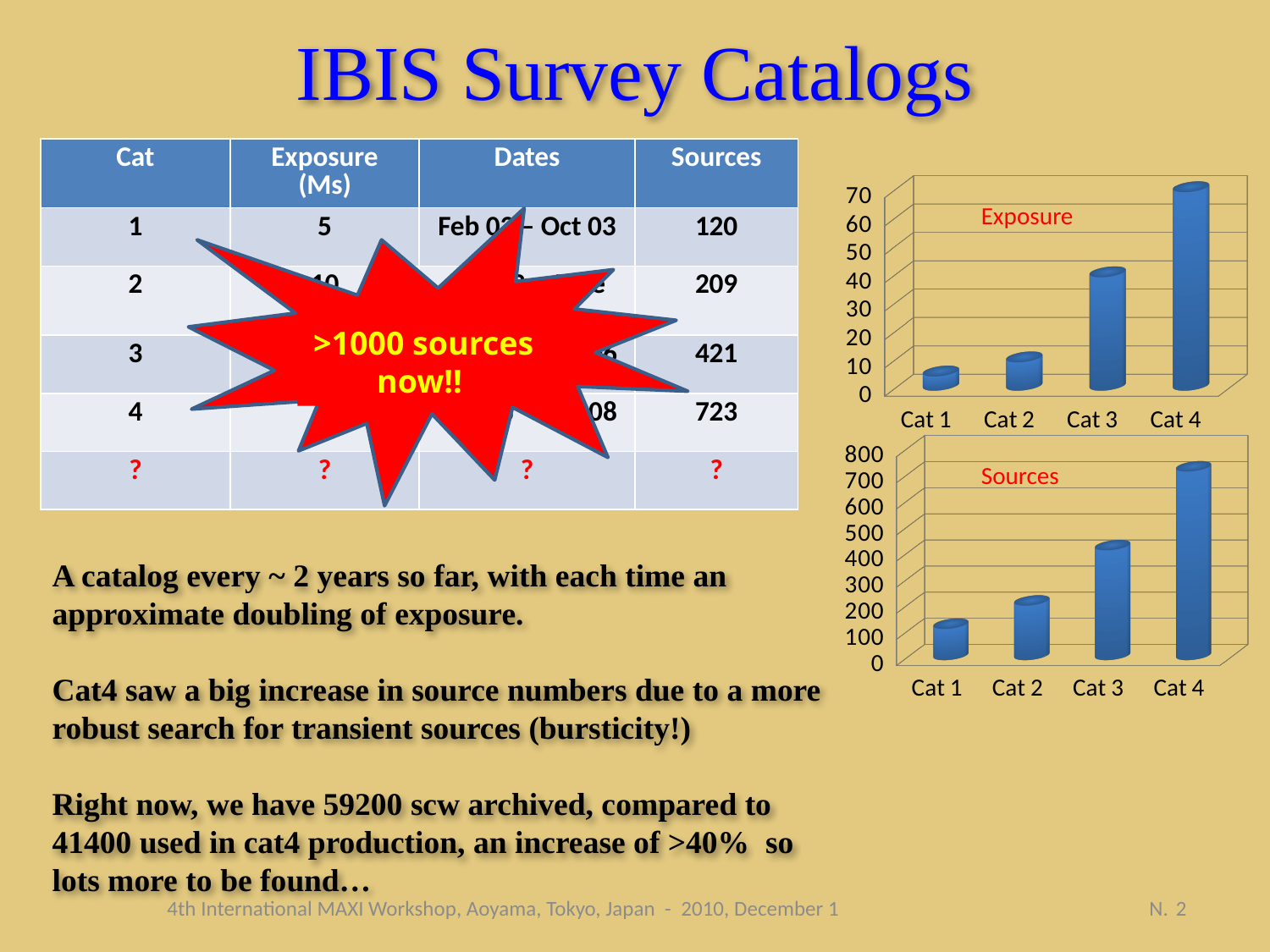
In the Sources chart, is the value for Cat 1 greater or less than 200? less How many categories are shown in the Sources chart? 4 In the Exposure chart, is the value for Cat 2 greater or less than 20? less In the Exposure chart, is the value for Cat 3 greater or less than 30? greater What kind of chart is the Exposure chart? bar chart In the Sources chart, which category has the highest value? Cat 4 In the Exposure chart, which category has the lowest value? Cat 1 In the Exposure chart, which is larger, the value for Cat 2 or the value for Cat 3? Cat 3 In the Sources chart, which category has the lowest value? Cat 1 In the Exposure chart, which category has the highest value? Cat 4 In the Sources chart, do the values rise or fall from Cat 1 to Cat 4? rise